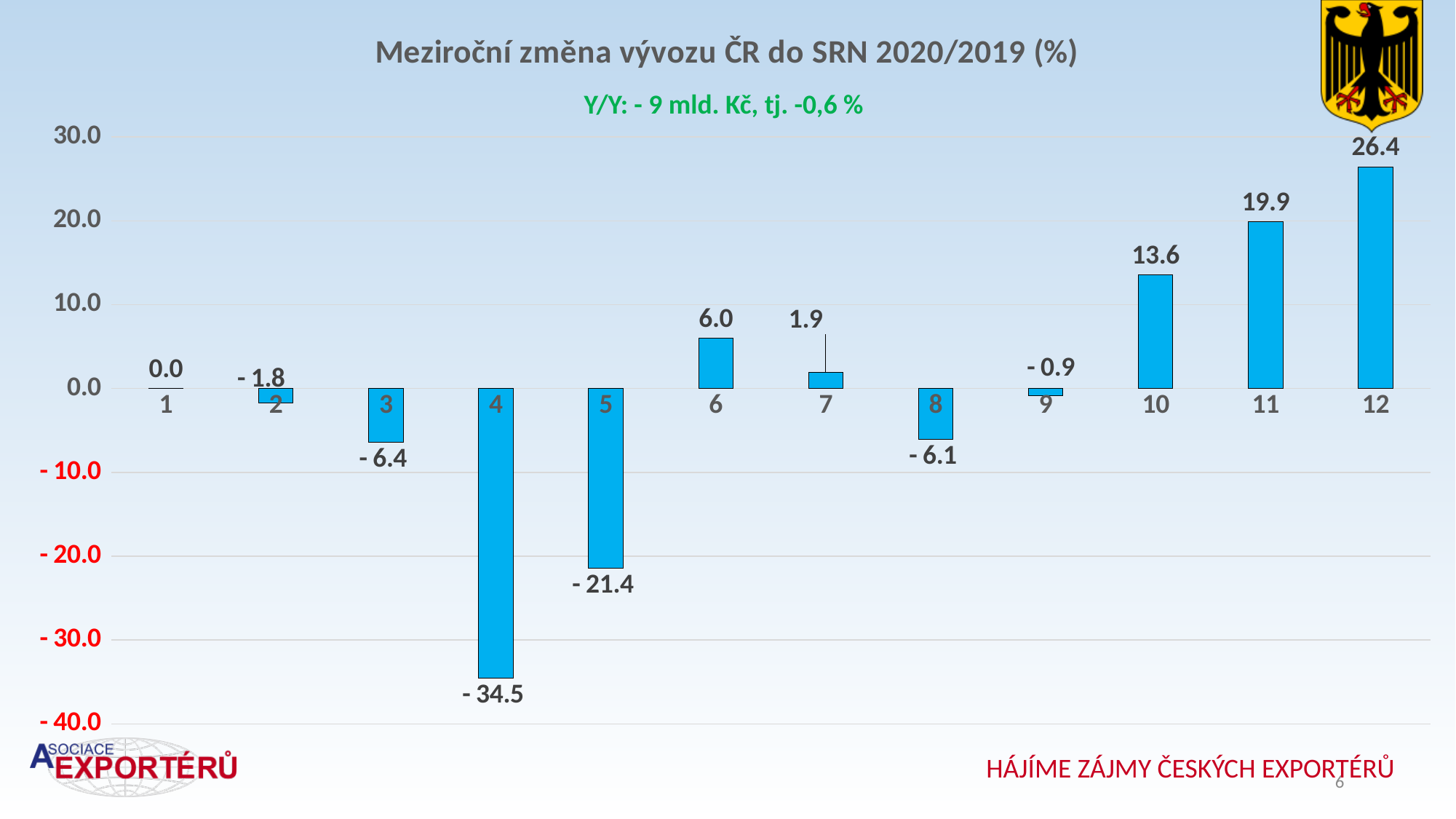
What is the value for month 4? - 34.5 What is the difference between the values for month 12 and month 11? 6.5 What is the title of the chart? Meziroční změna vývozu ČR do SRN 2020/2019 (%) How many months (categories) are plotted on the chart? 12 What type of chart is shown on the slide? bar chart What is the value for month 7? 1.9 Which is larger, the value for month 6 or the value for month 10? month 10 Which month has the highest value? 12 What is the value for month 12? 26.4 Which month has the lowest value? 4 What year-on-year change in mld. Kč is stated in the green subtitle? - 9 mld. Kč Do the values generally rise or fall from month 9 to month 12? rise